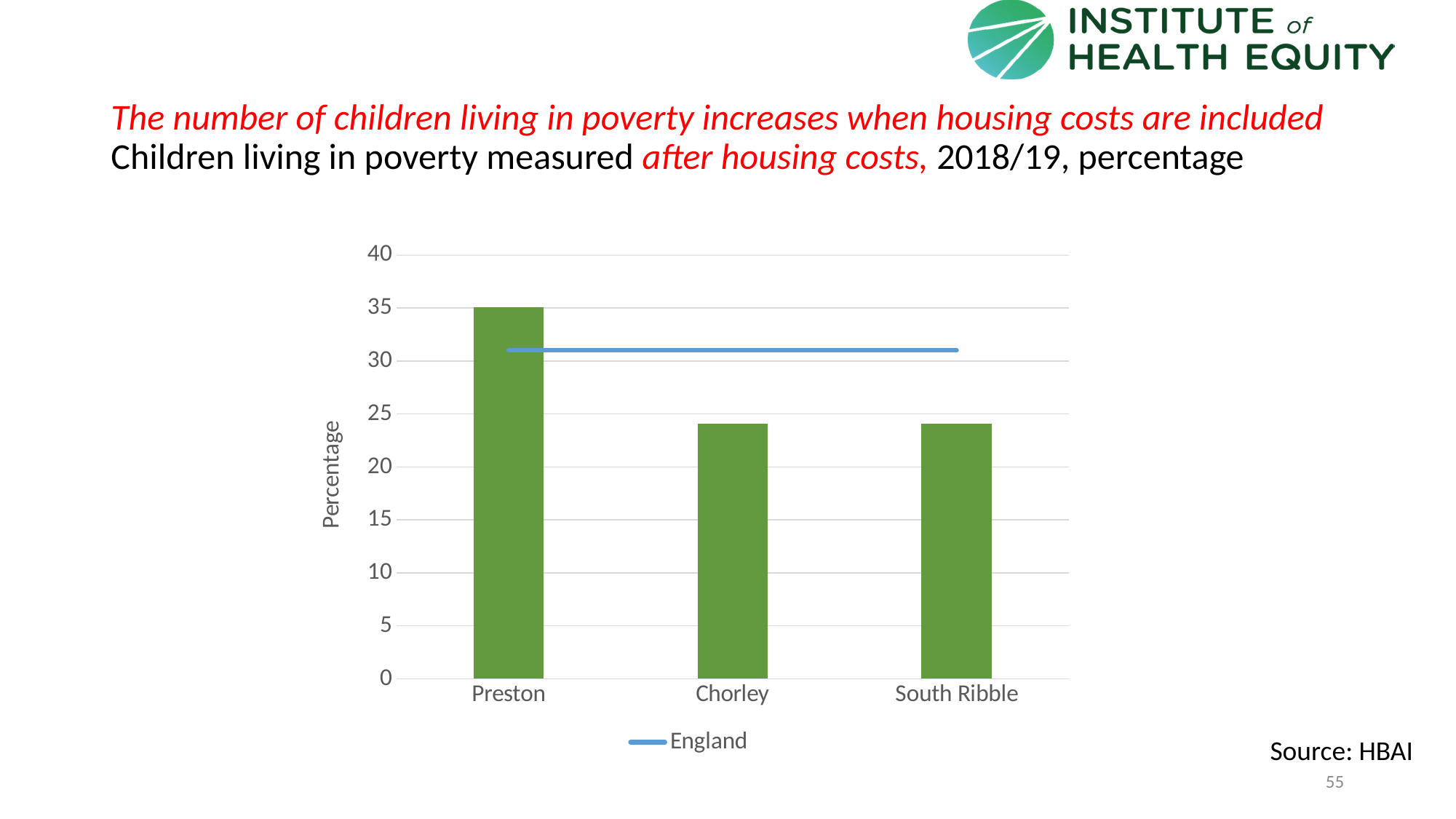
What kind of chart is shown on the slide? bar chart Is the value for Preston greater or less than the England line? greater Which has a higher value, Preston or Chorley? Preston Is the England line greater or less than 30? greater How many entries does the legend list? 1 What is the label on the vertical axis? Percentage What does the blue horizontal line on the chart represent? England Is the value for Preston greater or less than 30? greater Which area has the highest percentage of children living in poverty after housing costs? Preston How many areas are shown as bars on the chart? 3 Is the value for Chorley greater or less than 25? less